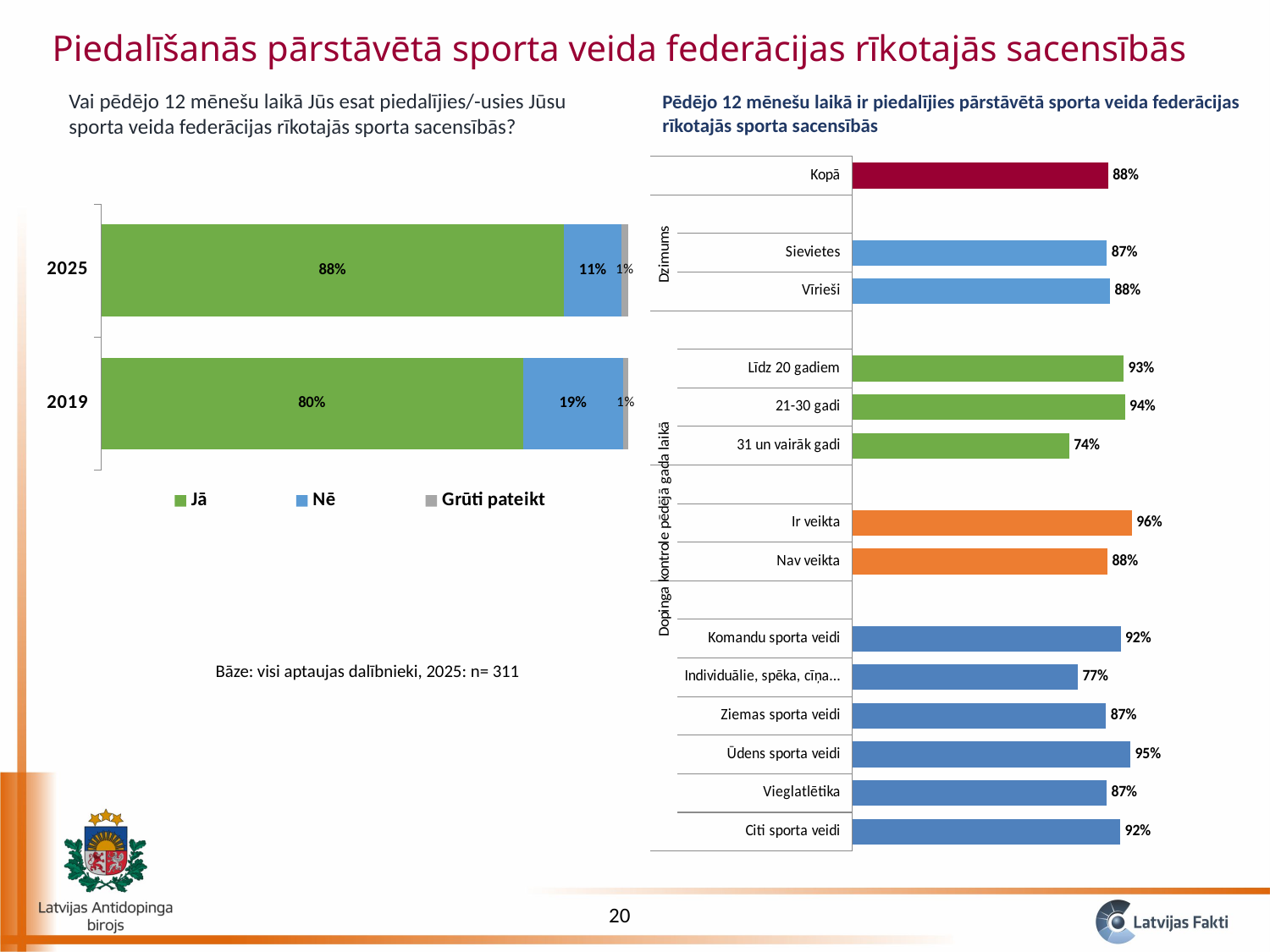
What kind of chart is the chart on the right side of the slide? Bar chart In the left stacked bar chart, what percentage answered "Nē" in 2019? 19% In the right bar chart, which category has the highest value? Ir veikta In the right bar chart, which category has the lowest value? 31 un vairāk gadi In the right bar chart, what is the value for "Kopā"? 88% In the left stacked bar chart, which year has the larger "Nē" share, 2025 or 2019? 2019 In the right bar chart, what is the value for "21-30 gadi"? 94% In the left stacked bar chart, by how many percentage points did the "Jā" share change from 2019 to 2025? 8 percentage points In the right bar chart, what is the difference between "Ir veikta" and "Nav veikta"? 8 percentage points In the left stacked bar chart, what percentage answered "Jā" in 2025? 88% In the right bar chart, which is larger, "Ūdens sporta veidi" or "Ziemas sporta veidi"? Ūdens sporta veidi In the left stacked bar chart, how many series does the legend list? 3